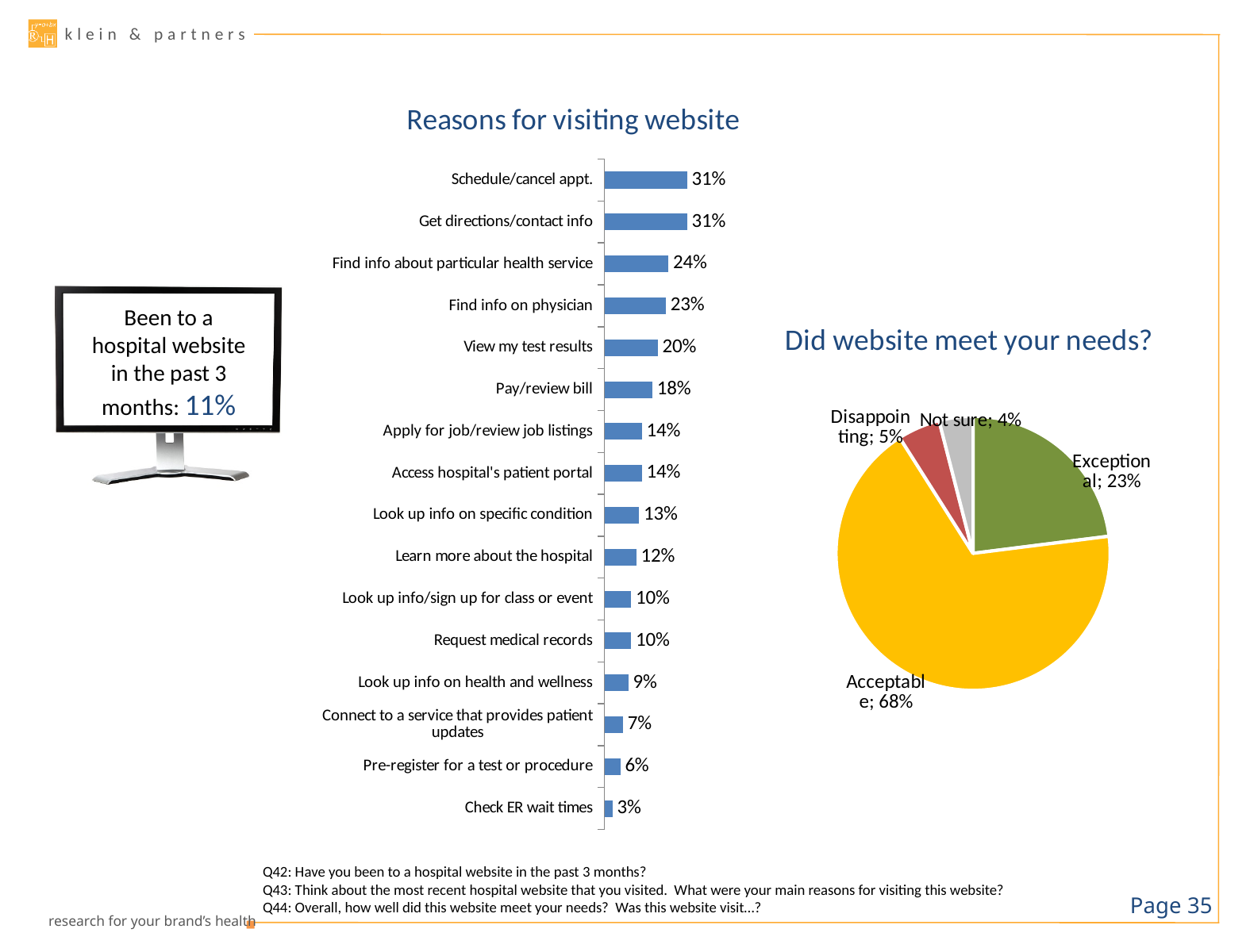
How many slices does the 'Did website meet your needs?' pie chart have? 4 What type of chart is 'Did website meet your needs?'? Pie chart In the 'Did website meet your needs?' chart, what share of respondents said 'Acceptable'? 68% How many reasons are listed in the 'Reasons for visiting website' chart? 16 In the 'Reasons for visiting website' chart, what percentage is shown for 'View my test results'? 20% In the 'Reasons for visiting website' chart, which reason has the lowest percentage? Check ER wait times In the 'Reasons for visiting website' chart, which is larger: 'Find info on physician' or 'Learn more about the hospital'? Find info on physician What type of chart is 'Reasons for visiting website'? Bar chart In the 'Did website meet your needs?' chart, which response has the largest slice? Acceptable In the 'Reasons for visiting website' chart, what is the difference between 'Find info about particular health service' and 'Pay/review bill'? 6% In the 'Did website meet your needs?' chart, what percentage said 'Not sure'? 4% In the 'Reasons for visiting website' chart, what percentage is shown for 'Check ER wait times'? 3%